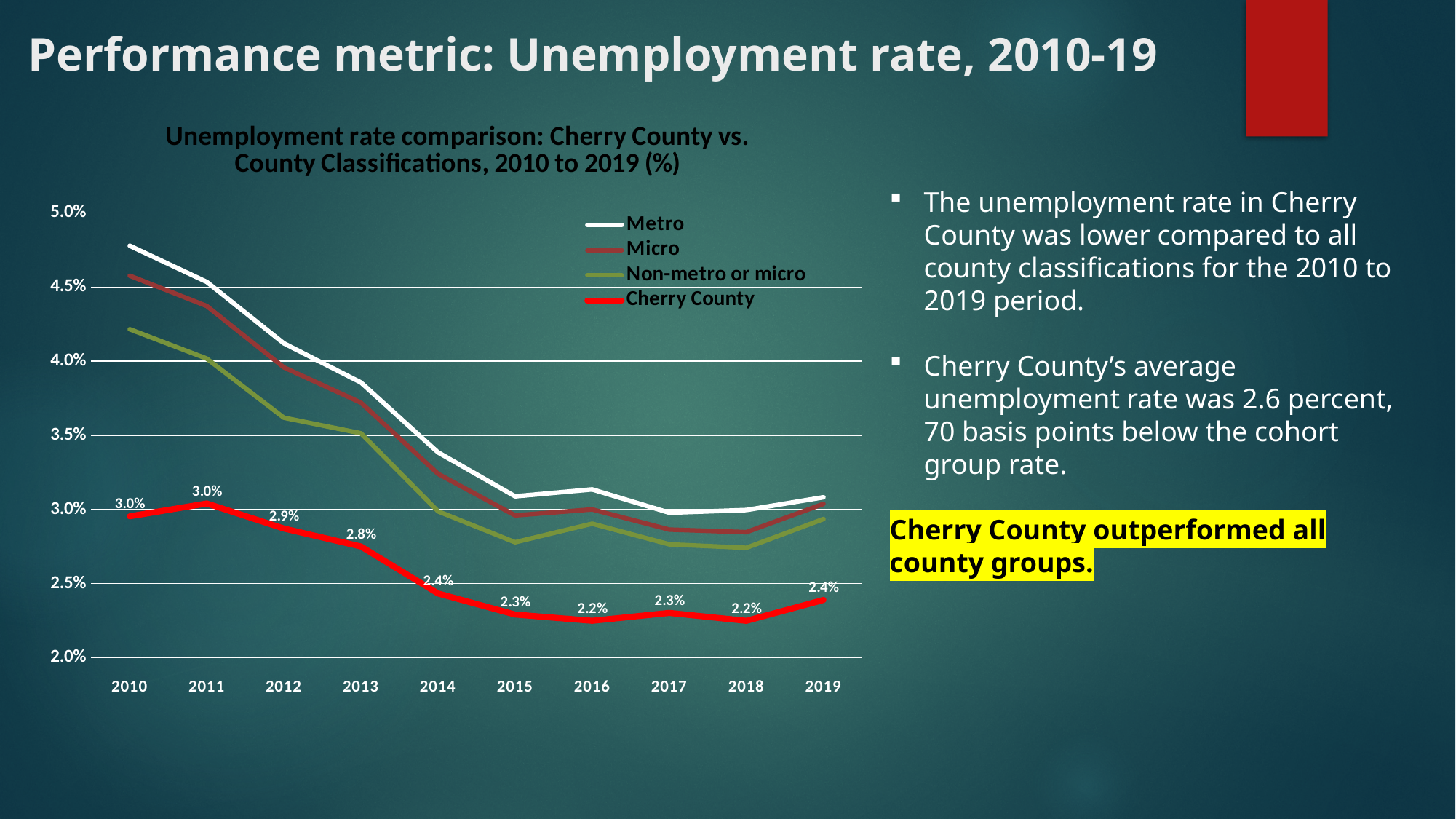
Is the Non-metro or micro unemployment rate in 2010 greater or less than 4.5%? less What was Cherry County's unemployment rate in 2019? 2.4% What kind of chart is shown on the slide? Line chart Did the Metro unemployment rate rise or fall from 2010 to 2015? Fall What was Cherry County's unemployment rate in 2016? 2.2% What was Cherry County's unemployment rate in 2013? 2.8% Which series had the higher unemployment rate in 2010, Metro or Cherry County? Metro How many years are shown on the x axis of the chart? 10 By how many percentage points did Cherry County's unemployment rate fall from 2010 to 2019? 0.6 percentage points Is the Metro unemployment rate in 2010 greater or less than 4.5%? greater How many series does the chart's legend list? 4